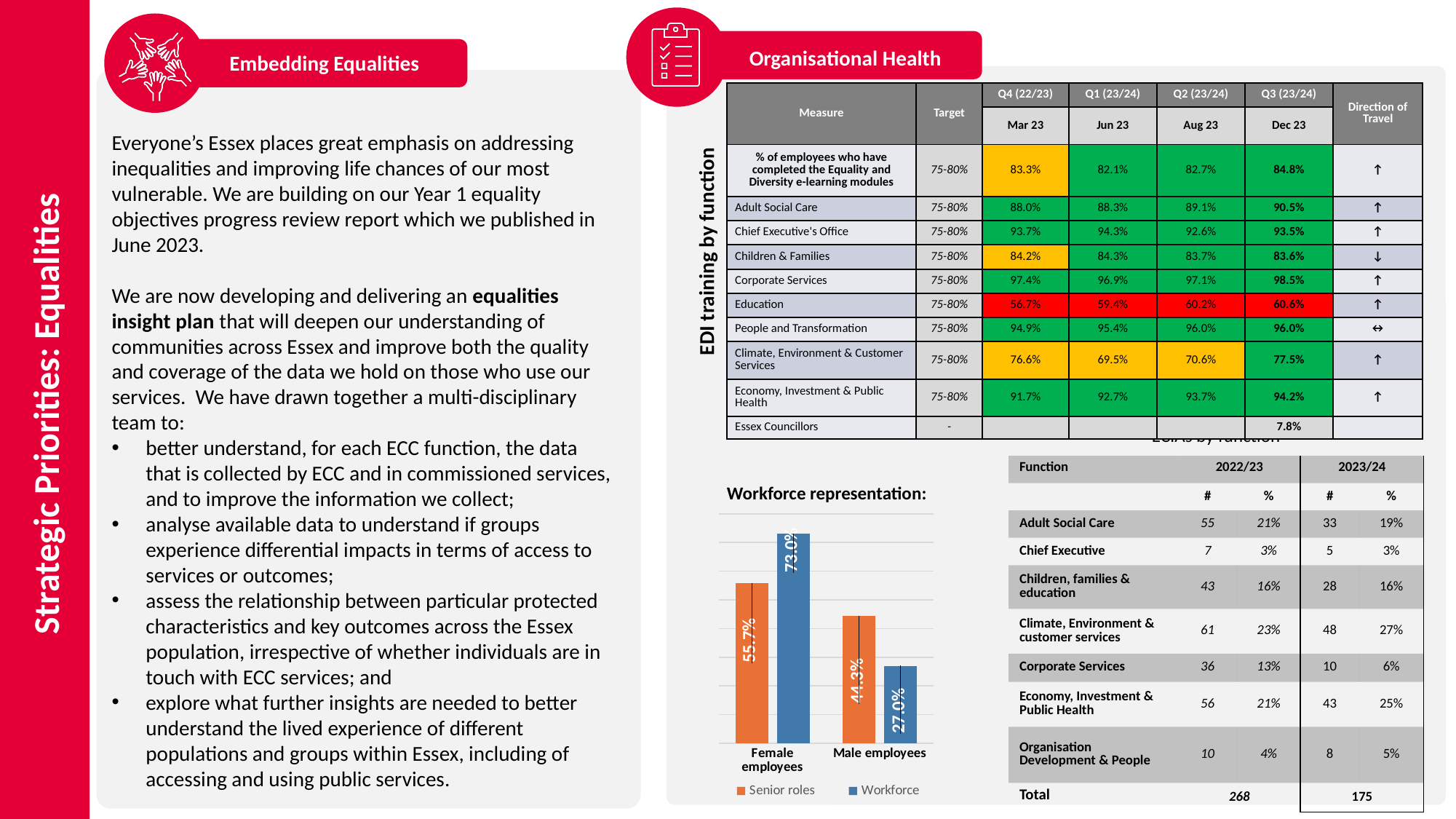
In the Workforce representation chart, which bar has the lowest value? Male employees, Workforce In the Workforce representation chart, what is the Workforce value for Male employees? 27.0% What type of chart is the Workforce representation chart? bar chart In the Workforce representation chart, what is the Workforce value for Female employees? 73.0% In the Workforce representation chart, what is the Senior roles value for Male employees? 44.3% In the Workforce representation chart, what is the difference between the Workforce and Senior roles values for Female employees? 17.3% How many series does the legend of the Workforce representation chart list? 2 In the Workforce representation chart, what is the difference between the Senior roles values for Female employees and Male employees? 11.4% In the Workforce representation chart, what is the Senior roles value for Female employees? 55.7% In the Workforce representation chart, which is larger for Male employees: Senior roles or Workforce? Senior roles In the Workforce representation chart, which bar has the highest value? Female employees, Workforce How many categories are shown on the x axis of the Workforce representation chart? 2